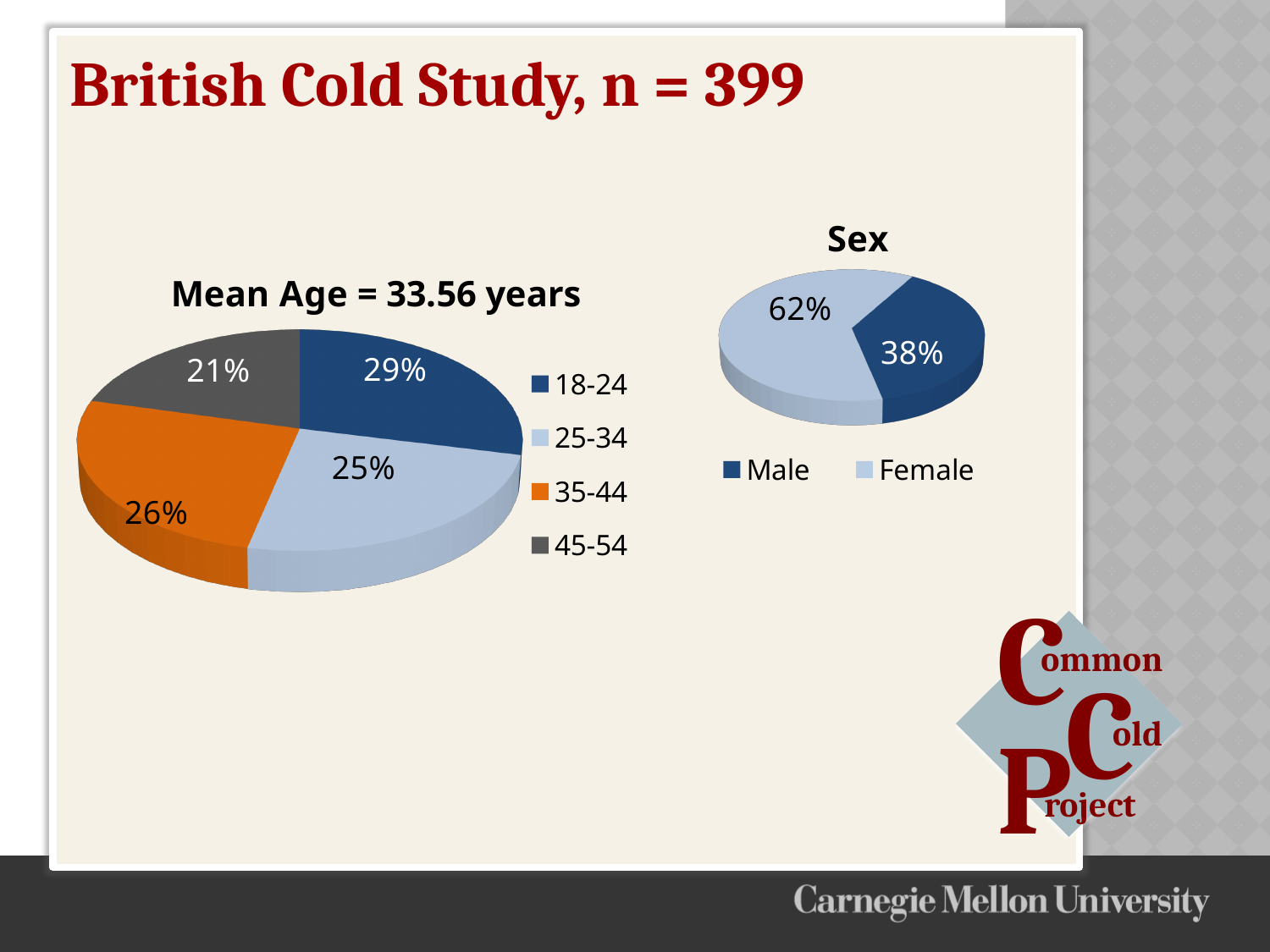
How many entries does the legend of the 'Sex' chart list? 2 What type of chart is the 'Mean Age = 33.56 years' chart? Pie chart In the 'Mean Age = 33.56 years' chart, how many age groups are shown? 4 In the 'Mean Age = 33.56 years' chart, which age group has the largest share? 18-24 In the 'Mean Age = 33.56 years' chart, which age group has the smallest share? 45-54 In the 'Sex' chart, how many percentage points larger is the Female share than the Male share? 24 In the 'Sex' chart, what percentage of participants are female? 62% In the 'Sex' chart, what percentage of participants are male? 38% In the 'Mean Age = 33.56 years' chart, what percentage is shown for the 18-24 age group? 29% In the 'Mean Age = 33.56 years' chart, how many percentage points larger is the 18-24 share than the 45-54 share? 8 In the 'Sex' chart, which is larger, the Male share or the Female share? Female In the 'Mean Age = 33.56 years' chart, what percentage is shown for the 35-44 age group? 26%